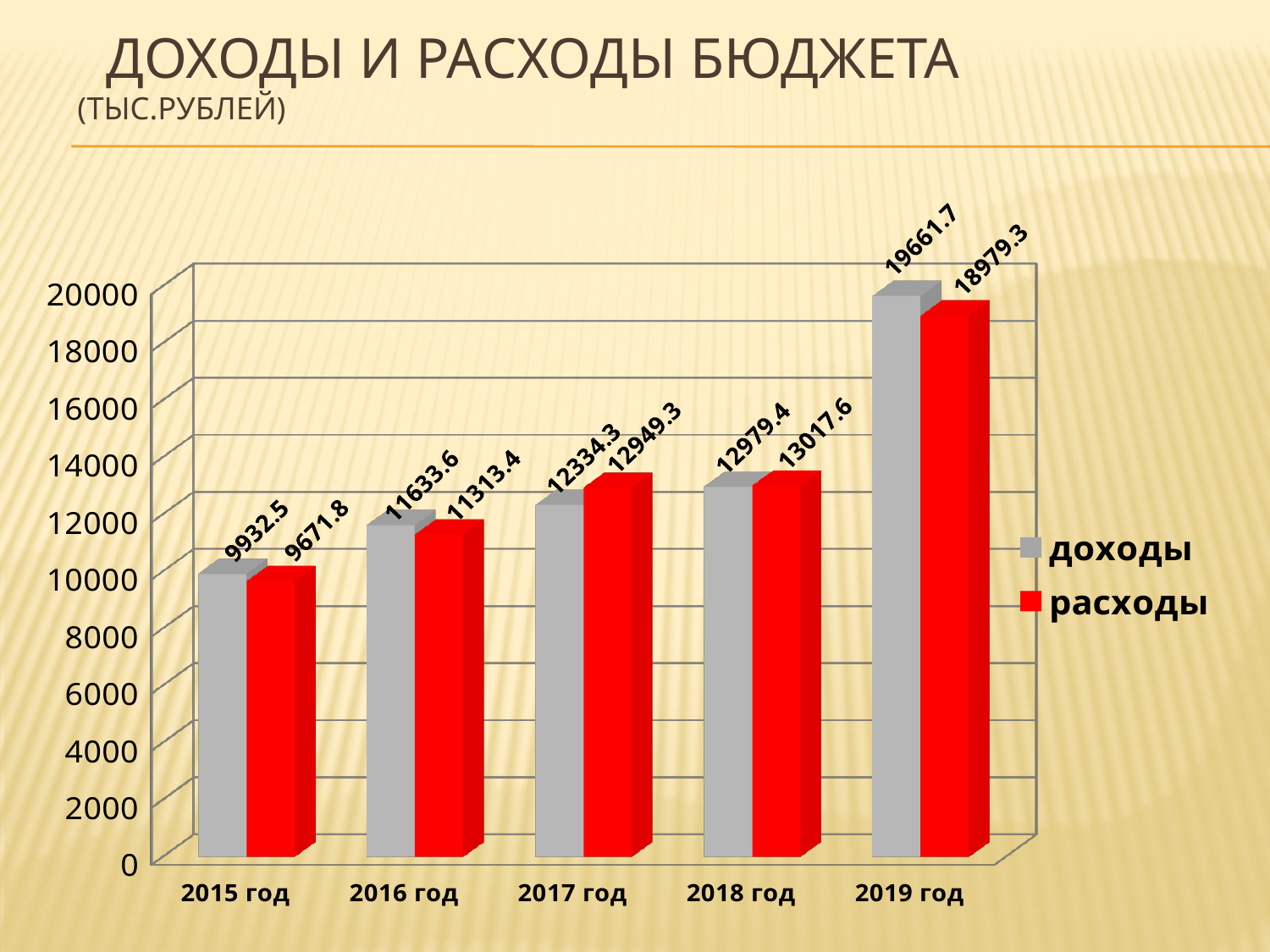
Which colour represents расходы in the legend? red What is the difference between доходы and расходы in 2019 год? 682.4 What type of chart is shown on the slide? bar chart What is the value of расходы for 2018 год? 13017.6 Do the доходы values rise or fall from 2015 год to 2019 год? rise In 2017 год, which is larger: доходы or расходы? расходы Which year has the highest value of расходы? 2019 год What is the value of доходы for 2015 год? 9932.5 Which year has the lowest value of доходы? 2015 год How many years are shown on the x axis? 5 How many series does the legend list? 2 What is the value of доходы for 2019 год? 19661.7